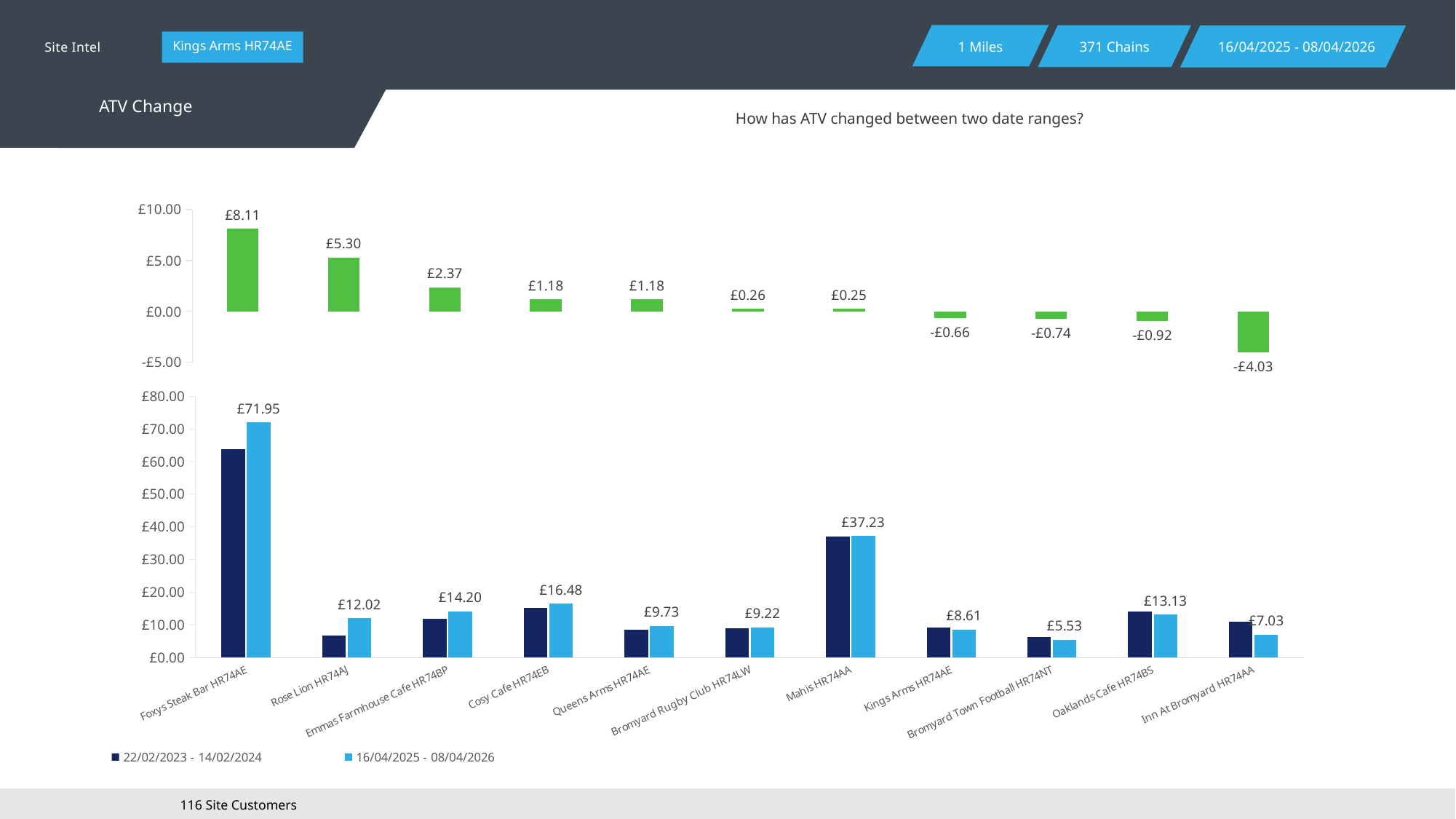
How many sites are shown on the x axis of the bottom chart? 11 How many series does the legend of the bottom chart list? 2 In the bottom chart, which has the larger value in the 16/04/2025 - 08/04/2026 series: Cosy Cafe HR74EB or Emmas Farmhouse Cafe HR74BP? Cosy Cafe HR74EB In the bottom chart, is the value for Foxys Steak Bar HR74AE in the 22/02/2023 - 14/02/2024 series greater or less than £60.00? greater What kind of chart is the bottom chart? bar chart In the top chart, what is the ATV change for Kings Arms HR74AE? -£0.66 In the top chart, which site has the lowest ATV change? Inn At Bromyard HR74AA In the bottom chart, what is the difference between the 16/04/2025 - 08/04/2026 values for Oaklands Cafe HR74BS and Inn At Bromyard HR74AA? £6.10 In the top chart, what is the difference between the ATV change for Foxys Steak Bar HR74AE and Rose Lion HR74AJ? £2.81 In the top chart, which site has the highest ATV change? Foxys Steak Bar HR74AE In the bottom chart, what is the value for Mahis HR74AA in the 16/04/2025 - 08/04/2026 series? £37.23 In the top chart, what is the ATV change for Rose Lion HR74AJ? £5.30